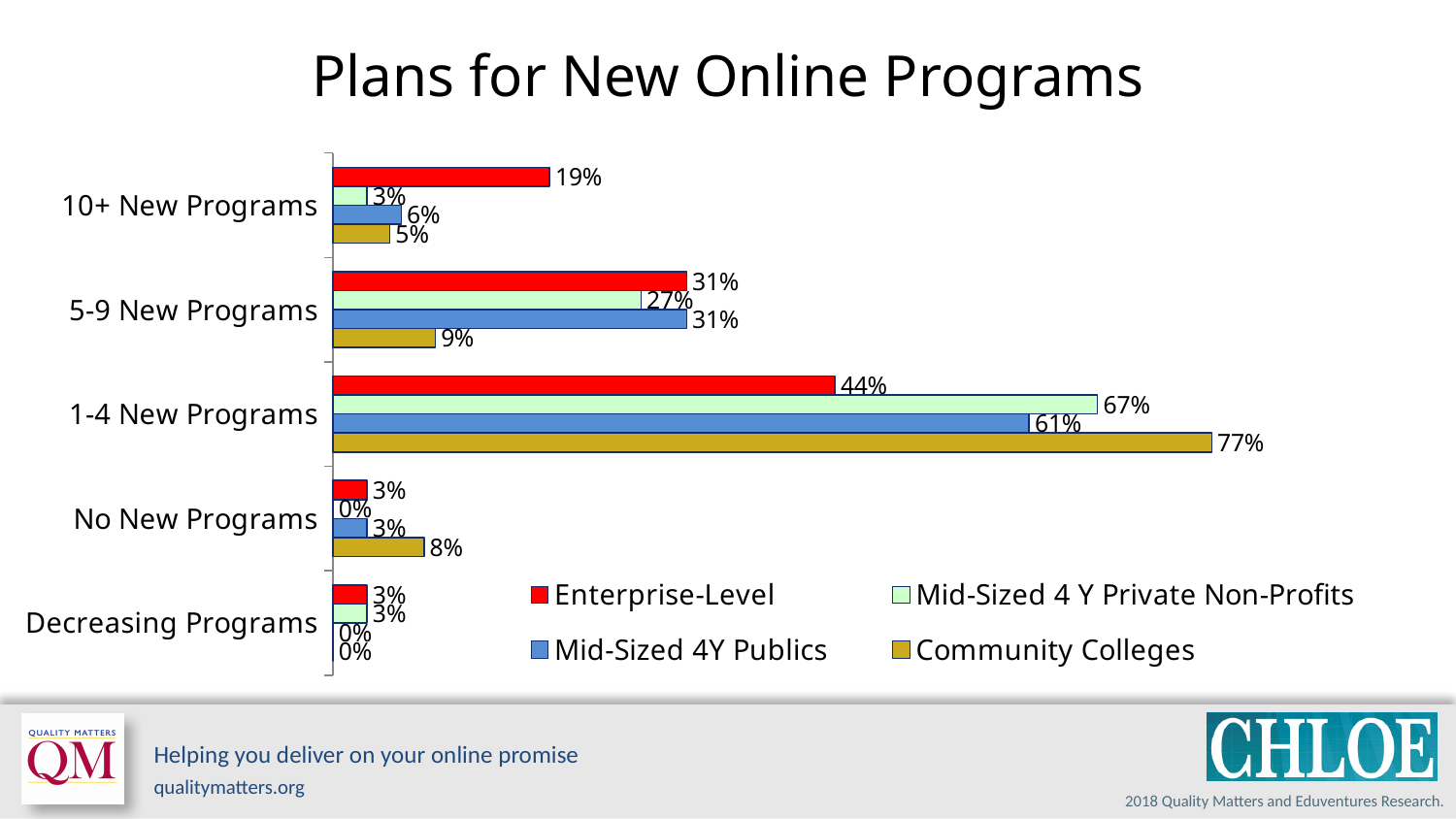
What is the value for Mid-Sized 4Y Publics in the No New Programs category? 3% Which series has the lowest value in the 5-9 New Programs category? Community Colleges What is the value for Enterprise-Level in the 10+ New Programs category? 19% What kind of chart is shown on the slide? bar chart Which series has the highest value in the 1-4 New Programs category? Community Colleges How many series does the legend list? 4 What is the value for Mid-Sized 4 Y Private Non-Profits in the 5-9 New Programs category? 27% What is the value for Community Colleges in the 1-4 New Programs category? 77% How many categories are shown on the vertical axis? 5 What is the title of the chart? Plans for New Online Programs In the 10+ New Programs category, which is larger: the Enterprise-Level value or the Mid-Sized 4Y Publics value? Enterprise-Level What is the difference between the Community Colleges and Enterprise-Level values in the 1-4 New Programs category? 33%